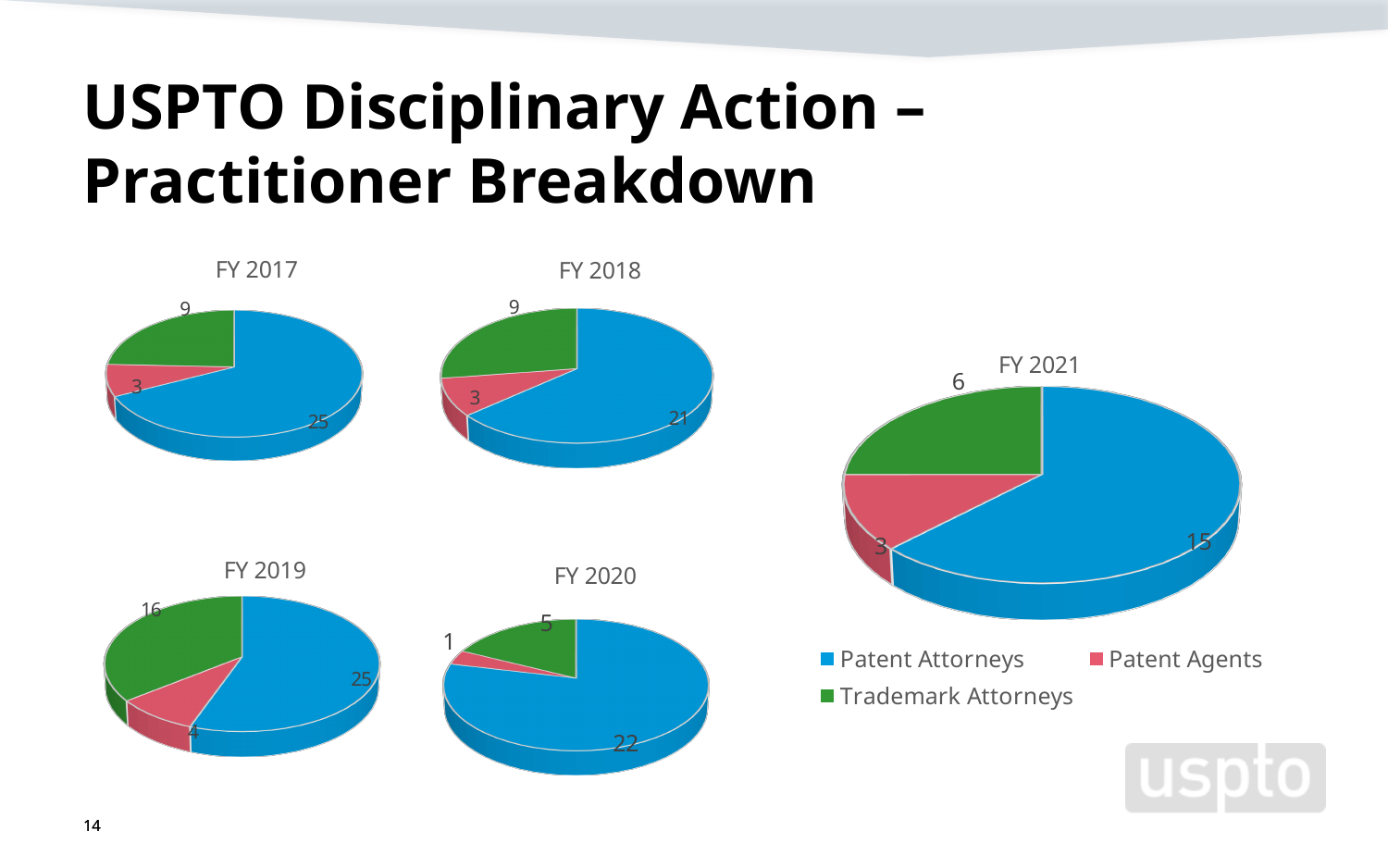
In the FY 2020 pie chart, what is the value for Patent Attorneys? 22 In the FY 2020 pie chart, which category has the smallest slice? Patent Agents In the FY 2019 pie chart, what is the value for Patent Agents? 4 In the FY 2017 pie chart, what is the value for Patent Attorneys? 25 In the FY 2021 pie chart, which category has the largest slice? Patent Attorneys What kind of chart is used for FY 2021? Pie chart In the FY 2019 pie chart, what is the difference between the Patent Attorneys value and the Trademark Attorneys value? 9 How many series does the legend list? 3 In the FY 2018 pie chart, what is the value for Trademark Attorneys? 9 Which is larger: the Trademark Attorneys value in FY 2019 or the Trademark Attorneys value in FY 2021? FY 2019 In the FY 2021 pie chart, what is the total of all slices? 24 Which colour represents Patent Agents in the legend? Red